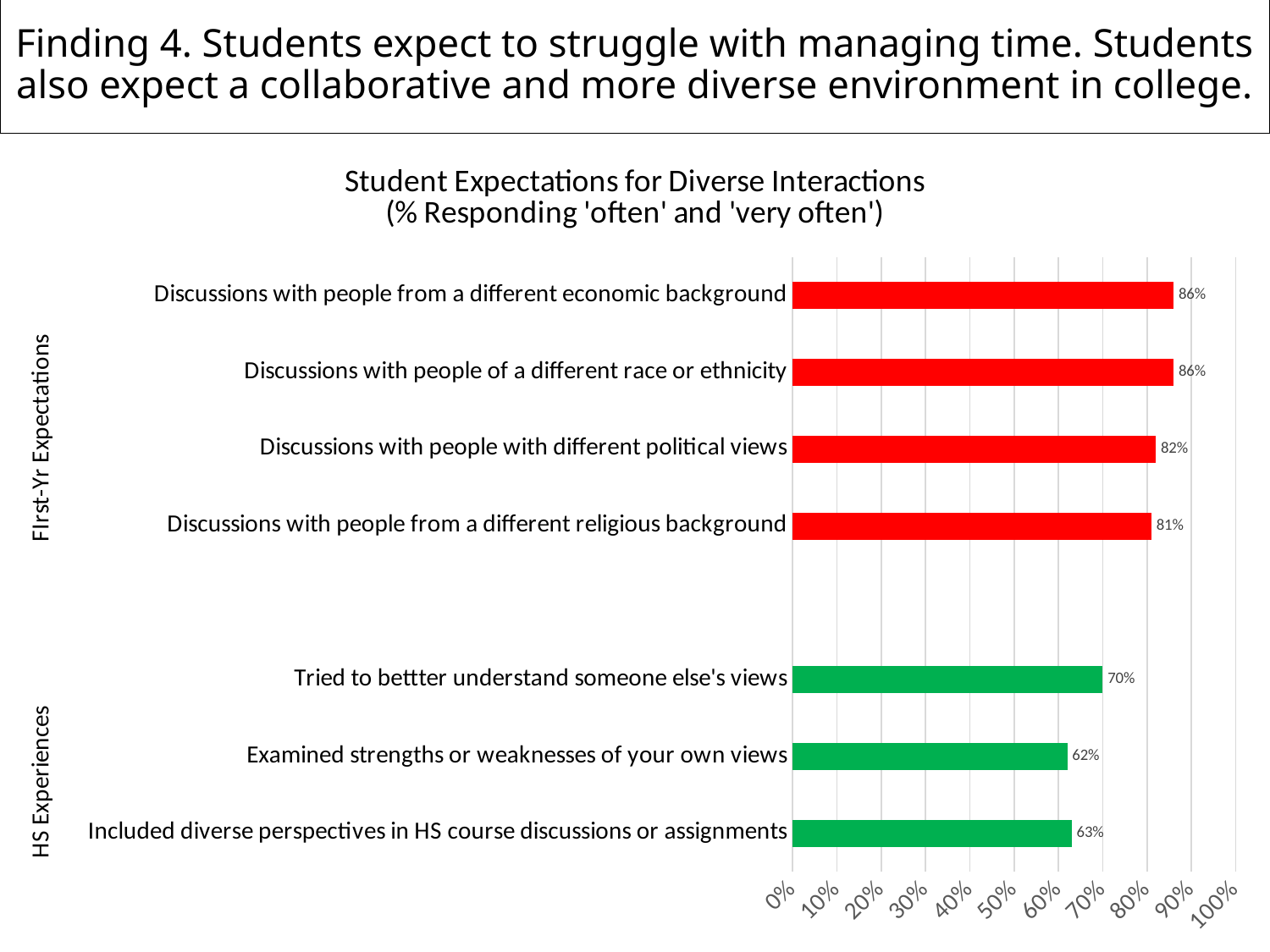
What is the value for 'Discussions with people with different political views'? 82% How many categories are plotted in the chart? 7 What is the value for 'Discussions with people from a different religious background'? 81% What colour are the bars in the 'HS Experiences' group? green What kind of chart is shown on the slide? bar chart What is the difference between 'Discussions with people from a different economic background' and 'Included diverse perspectives in HS course discussions or assignments'? 23% What is the value for 'Examined strengths or weaknesses of your own views'? 62% Which category has the lowest value? Examined strengths or weaknesses of your own views What is the title of the chart? Student Expectations for Diverse Interactions (% Responding 'often' and 'very often') Which is larger: 'Discussions with people with different political views' or 'Tried to bettter understand someone else's views'? Discussions with people with different political views What is the value for 'Tried to bettter understand someone else's views'? 70% Is the value for 'Included diverse perspectives in HS course discussions or assignments' greater or less than 70%? less